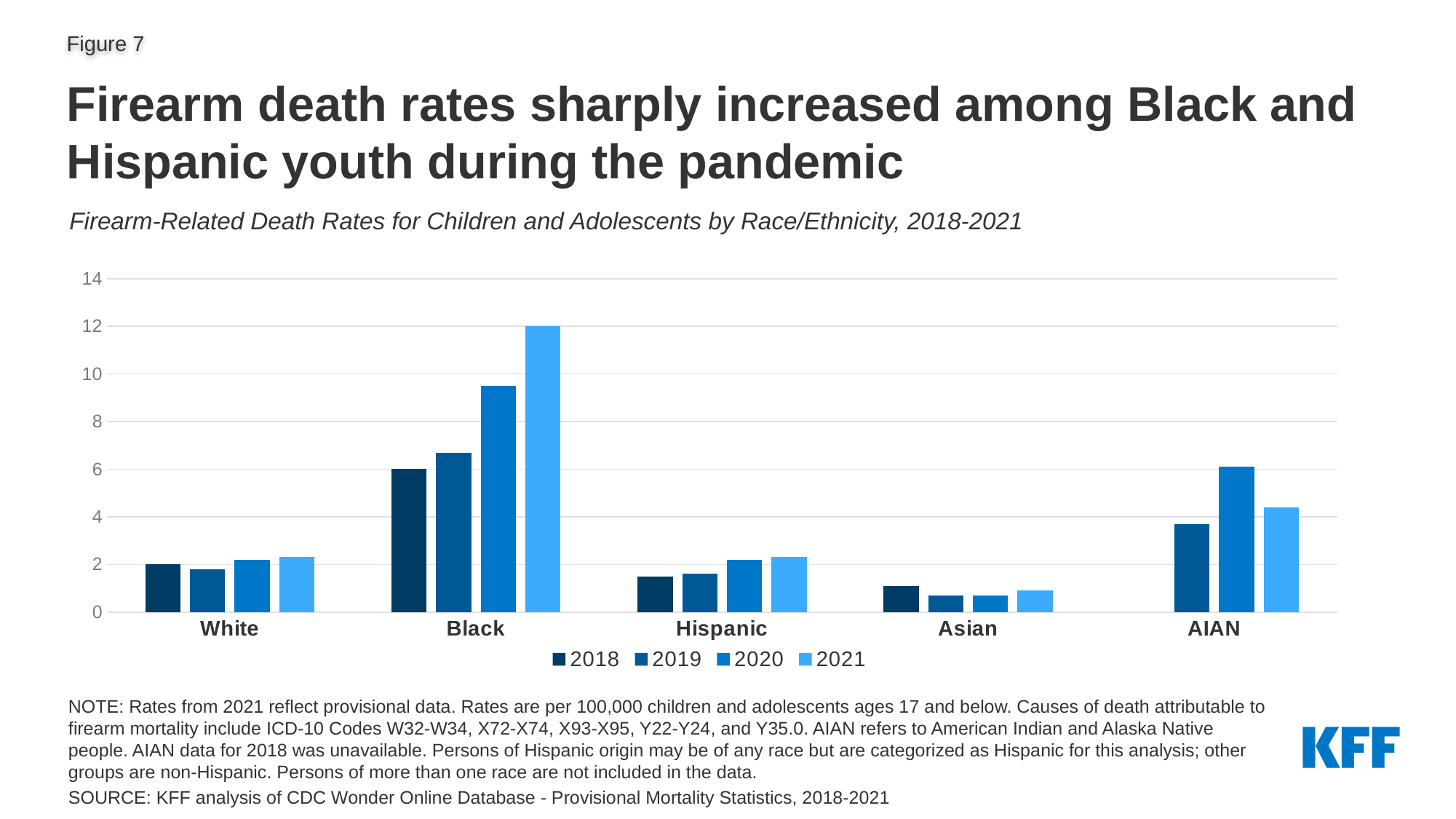
What kind of chart is shown on the slide? bar chart Is the 2019 value for Asian children and adolescents greater or less than 2? less Which race/ethnicity group has the highest firearm-related death rate in 2021? Black Is the 2020 value for Black children and adolescents greater or less than 8? greater How many race/ethnicity categories are shown on the x axis? 5 What is the firearm-related death rate for Black children and adolescents in 2021? 12 Do the firearm-related death rates for Black children and adolescents rise or fall from 2018 to 2021? rise Is the 2021 value for AIAN children and adolescents greater or less than 4? greater Which is larger: the 2021 value for Black or the 2020 value for AIAN? Black 2021 What is the firearm-related death rate for Black children and adolescents in 2018? 6 Which race/ethnicity group has the lowest firearm-related death rate in 2020? Asian How many series does the legend list? 4